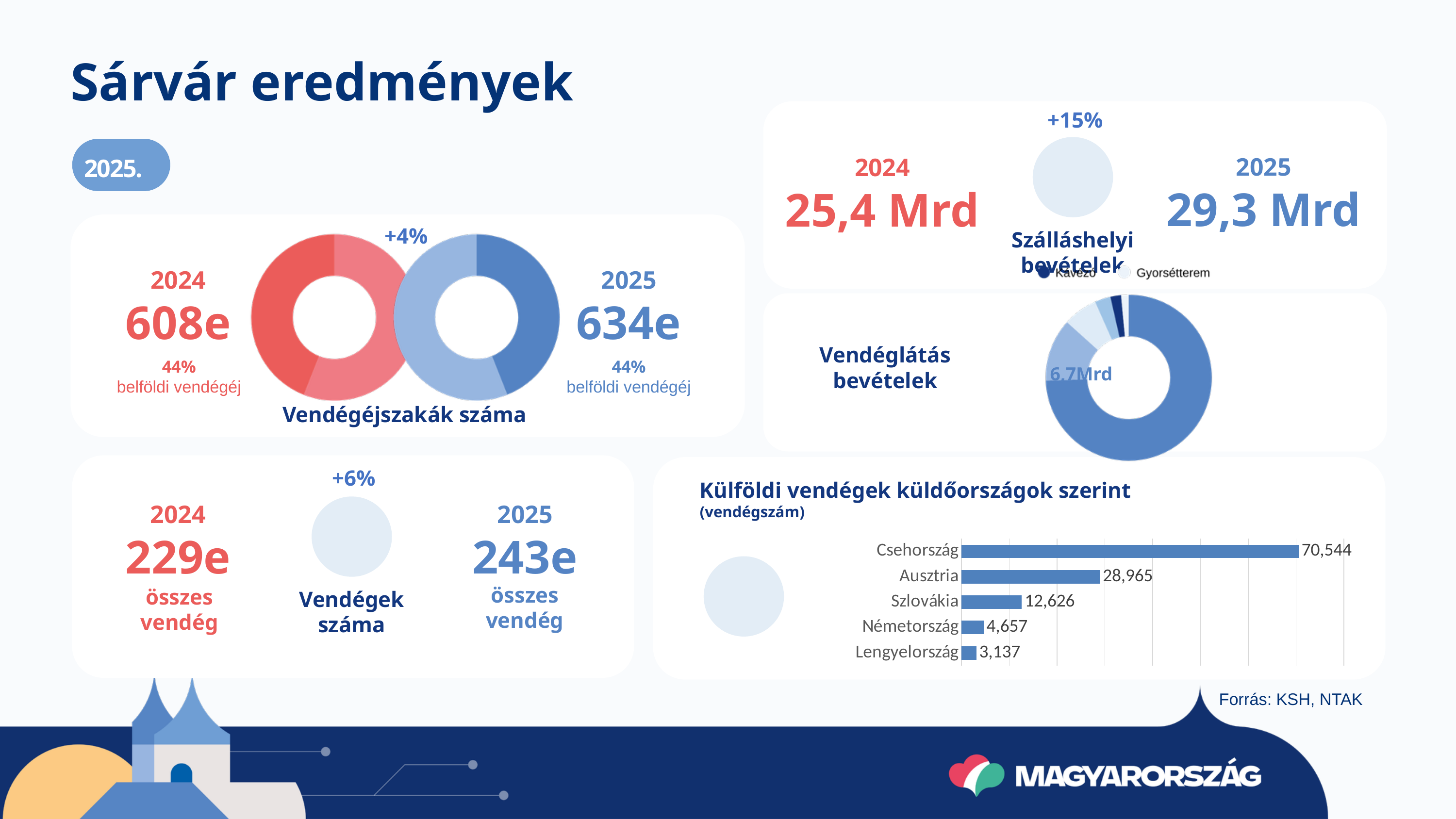
In the 'Külföldi vendégek küldőországok szerint' chart, which country has the highest value? Csehország In the 'Külföldi vendégek küldőországok szerint' chart, what is the value for Lengyelország? 3,137 In the 'Külföldi vendégek küldőországok szerint' chart, what is the difference between Csehország and Ausztria? 41,579 In the 'Külföldi vendégek küldőországok szerint' chart, which is larger, Szlovákia or Németország? Szlovákia In the 'Külföldi vendégek küldőországok szerint' chart, which country has the lowest value? Lengyelország In the 'Külföldi vendégek küldőországok szerint' chart, what is the value for Szlovákia? 12,626 How many countries are shown in the 'Külföldi vendégek küldőországok szerint' chart? 5 In the 'Külföldi vendégek küldőországok szerint' chart, what is the difference between Németország and Lengyelország? 1,520 In the 'Külföldi vendégek küldőországok szerint' chart, what is the value for Ausztria? 28,965 What kind of chart is 'Külföldi vendégek küldőországok szerint'? Bar chart In the 'Külföldi vendégek küldőországok szerint' chart, what is the value for Csehország? 70,544 In the 2024 'Vendégéjszakák száma' donut chart, what share is belföldi vendégéj? 44%